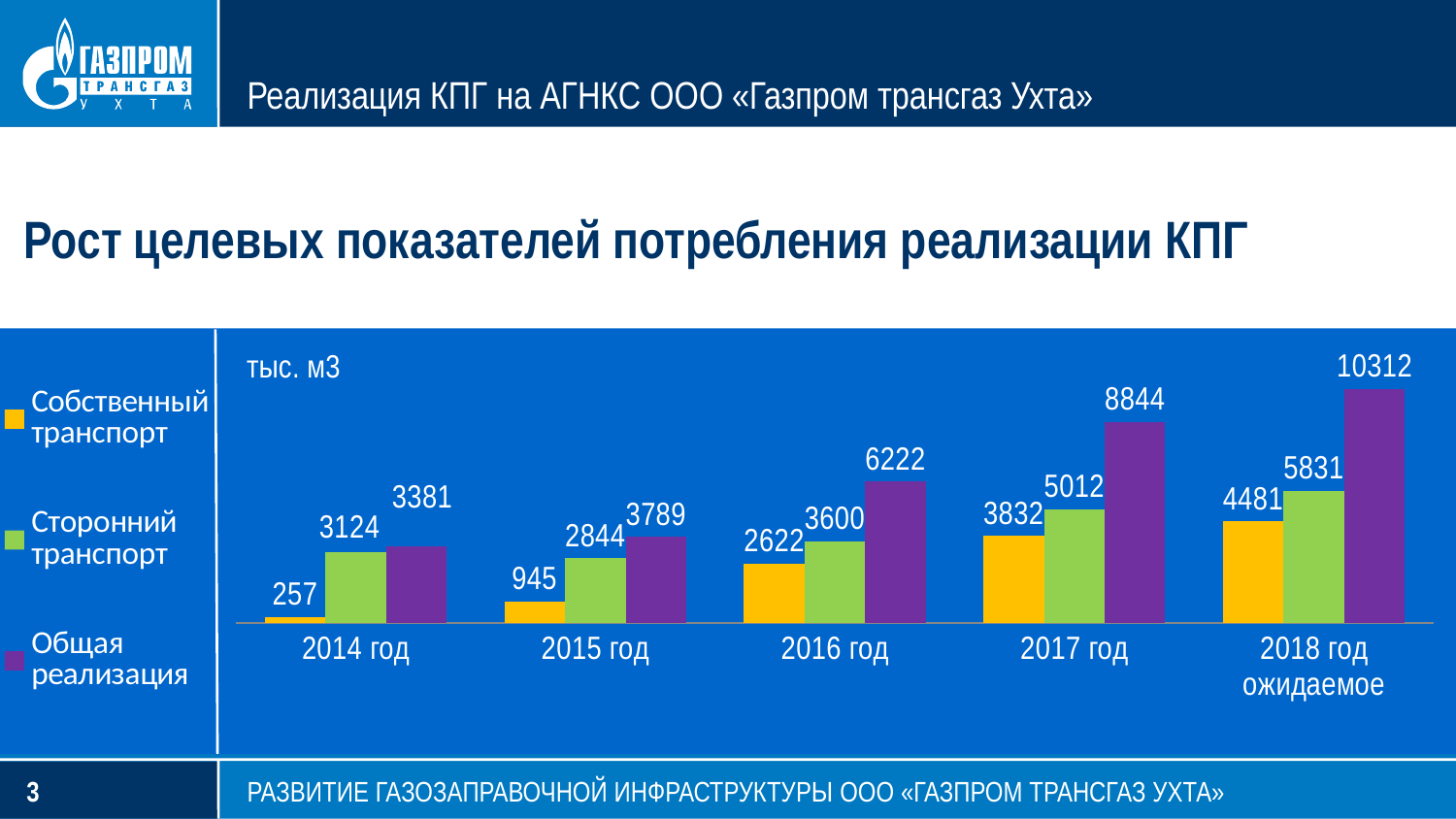
Which is larger: Сторонний транспорт in 2014 год or Сторонний транспорт in 2015 год? Сторонний транспорт in 2014 год What is the value for Общая реализация in 2018 год ожидаемое? 10312 Does Общая реализация rise or fall from 2014 год to 2018 год ожидаемое? rise What is the value for Собственный транспорт in 2014 год? 257 What kind of chart is shown on the slide? bar chart How many year categories are shown on the x axis? 5 How many series does the legend list? 3 In which year is Общая реализация the highest? 2018 год ожидаемое What is the difference between Общая реализация in 2017 год and in 2016 год? 2622 In which year is Собственный транспорт the lowest? 2014 год What unit is shown in the top-left corner of the chart? тыс. м3 What is the value for Сторонний транспорт in 2016 год? 3600